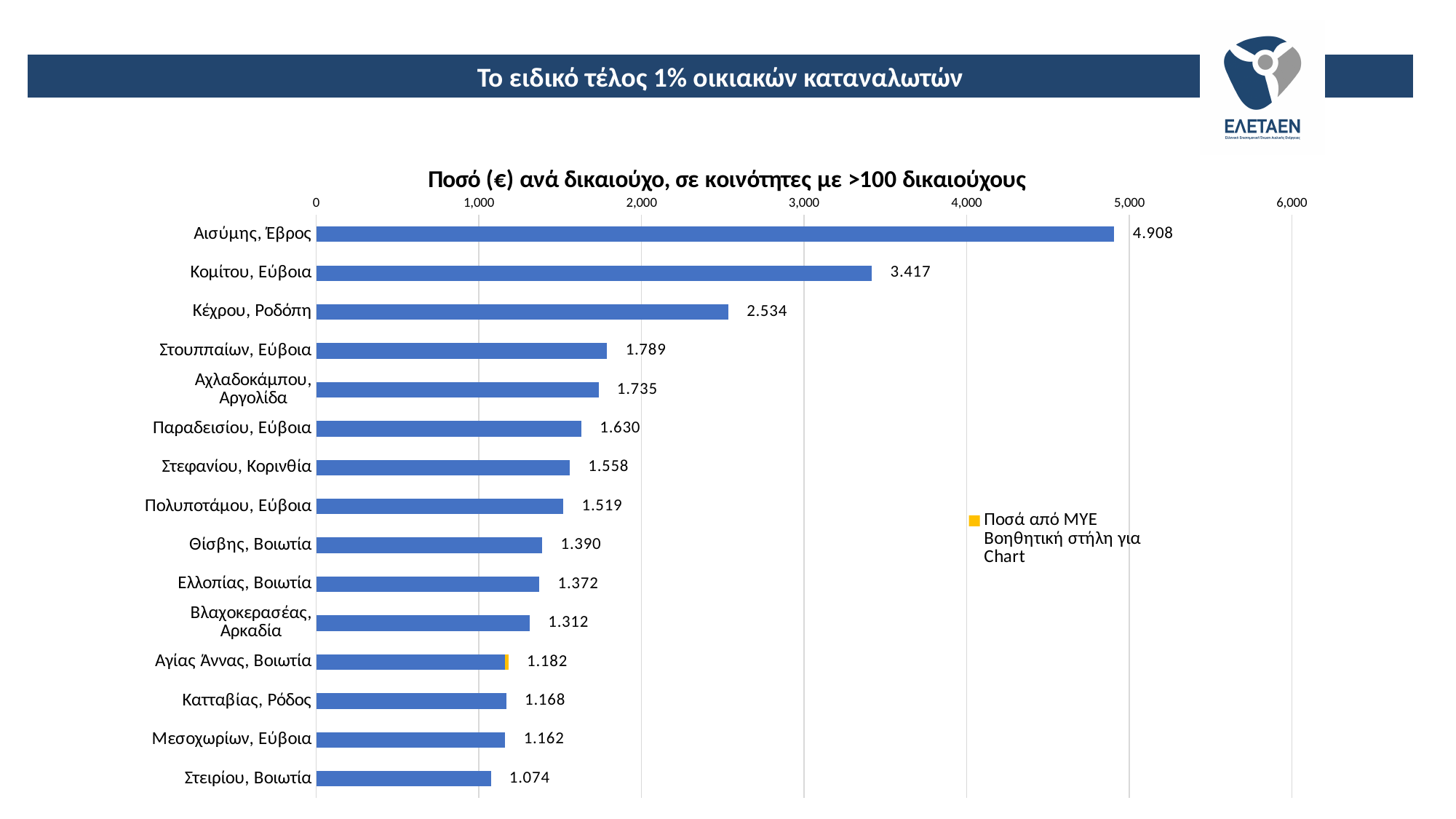
Is the value for Κομίτου, Εύβοια greater or less than 3,000? greater What is the difference between the values for Αισύμης, Έβρος and Κομίτου, Εύβοια? 1.491 What is the title of the chart? Ποσό (€) ανά δικαιούχο, σε κοινότητες με >100 δικαιούχους What is the value for Κέχρου, Ροδόπη? 2.534 What is the value for Στειρίου, Βοιωτία? 1.074 What type of chart is shown on the slide? bar chart How many categories are shown in the chart? 15 Which is larger, the value for Παραδεισίου, Εύβοια or the value for Στεφανίου, Κορινθία? Παραδεισίου, Εύβοια Which category has the highest value? Αισύμης, Έβρος What is the value for Αισύμης, Έβρος? 4.908 Which category has the lowest value? Στειρίου, Βοιωτία What is the value for Θίσβης, Βοιωτία? 1.390